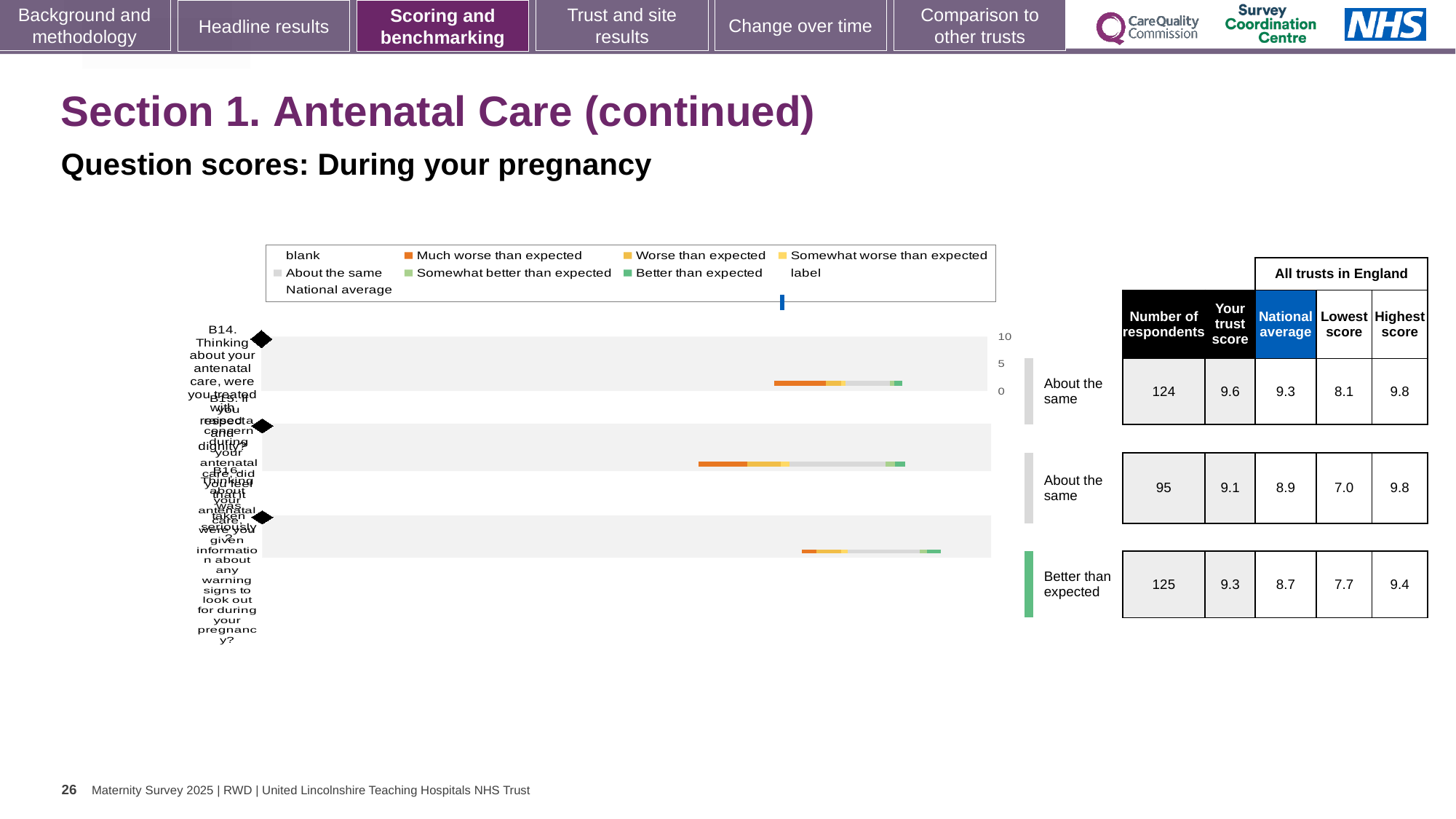
Which row in the table beside the chart has the highest 'Your trust score'? the first row (B14), 9.6 How many bars (questions) are plotted in the chart? 3 In the table beside the chart, what is 'Your trust score' for the first row (B14)? 9.6 For the first row of the table, which is larger: 'Your trust score' or the national average? Your trust score In the table beside the chart, what is the national average for the third row? 8.7 For the third row of the table, what is the difference between 'Your trust score' and the national average? 0.6 What kind of chart is shown on the slide? bar chart What is the lowest value in the 'Lowest score' column of the table beside the chart? 7.0 How many entries does the chart legend list? 9 What colour does the legend use for 'Much worse than expected'? orange In the table beside the chart, what is the number of respondents for the second row? 95 What is the highest tick value shown on the chart's axis? 10